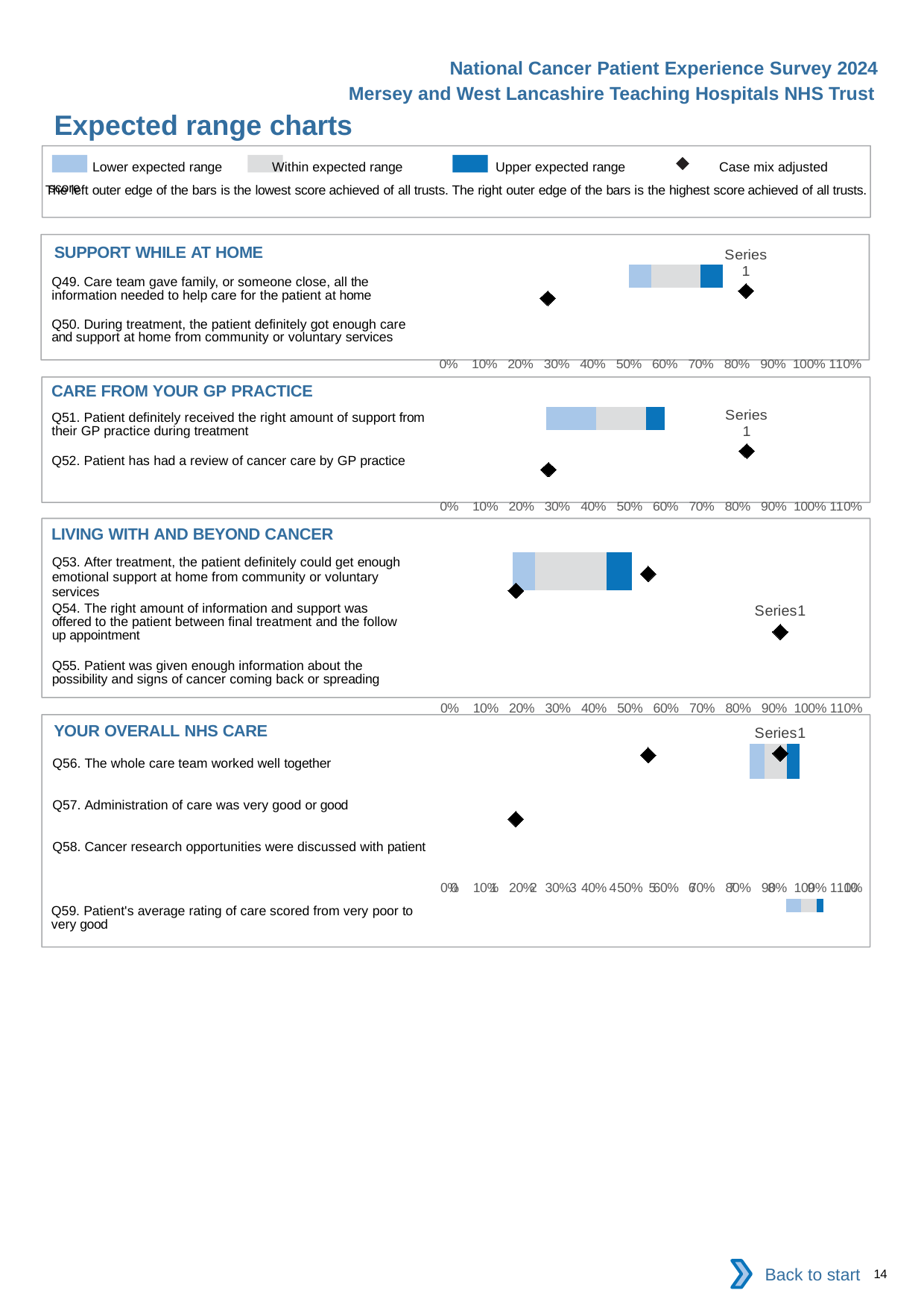
How many questions are listed in the SUPPORT WHILE AT HOME chart? 2 Which of the four section charts lists the most questions? YOUR OVERALL NHS CARE In the CARE FROM YOUR GP PRACTICE chart, is the left edge of the expected range bar for Q51 greater or less than 40%? less How many questions are listed in the LIVING WITH AND BEYOND CANCER chart? 3 In the LIVING WITH AND BEYOND CANCER chart, is the right edge of the expected range bar for Q53 greater or less than 40%? greater What kind of chart is used in the Expected range charts on this slide? bar chart How many entries does the legend at the top of the slide list? 4 What are the legend entries shown at the top of the slide? Lower expected range, Within expected range, Upper expected range, Case mix adjusted score In the SUPPORT WHILE AT HOME chart, is the left edge of the expected range bar for Q49 greater or less than 40%? greater What is the highest tick label shown on the x axis of the SUPPORT WHILE AT HOME chart? 110%